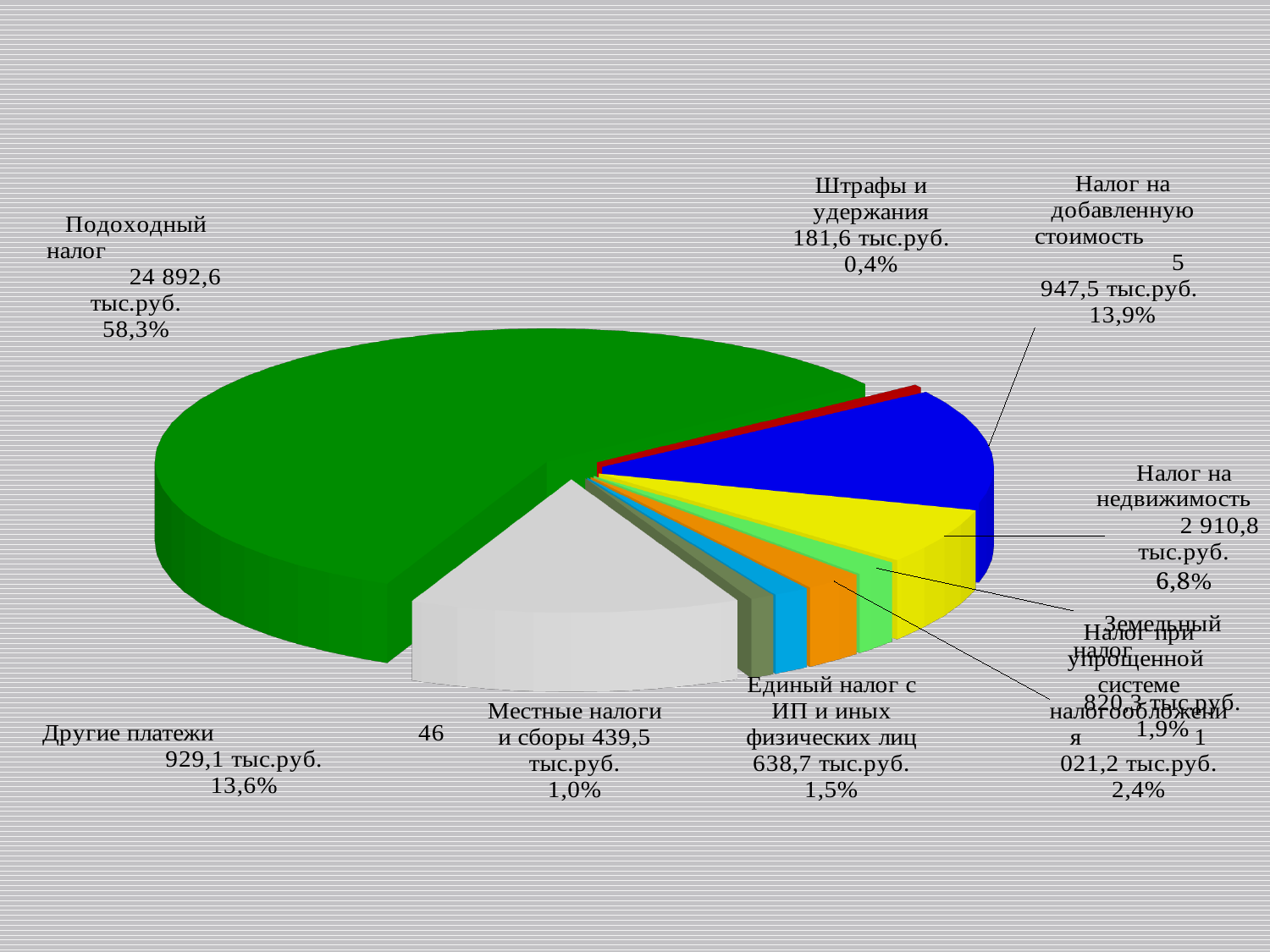
What is the value shown for Налог на добавленную стоимость? 5 947,5 тыс.руб. What kind of chart is shown on the slide? pie chart How many slices does the pie chart have? 9 What share of the pie does Подоходный налог account for? 58,3% What share of the pie does Налог на недвижимость account for? 6,8% Which category has the smallest share of the pie? Штрафы и удержания What share of the pie does Другие платежи account for? 13,6% Which category has the largest share of the pie? Подоходный налог What is the value shown for Подоходный налог? 24 892,6 тыс.руб. What is the value shown for Местные налоги и сборы? 439,5 тыс.руб. Which is larger: the share for Налог на добавленную стоимость or the share for Налог на недвижимость? Налог на добавленную стоимость What is the value shown for Штрафы и удержания? 181,6 тыс.руб.